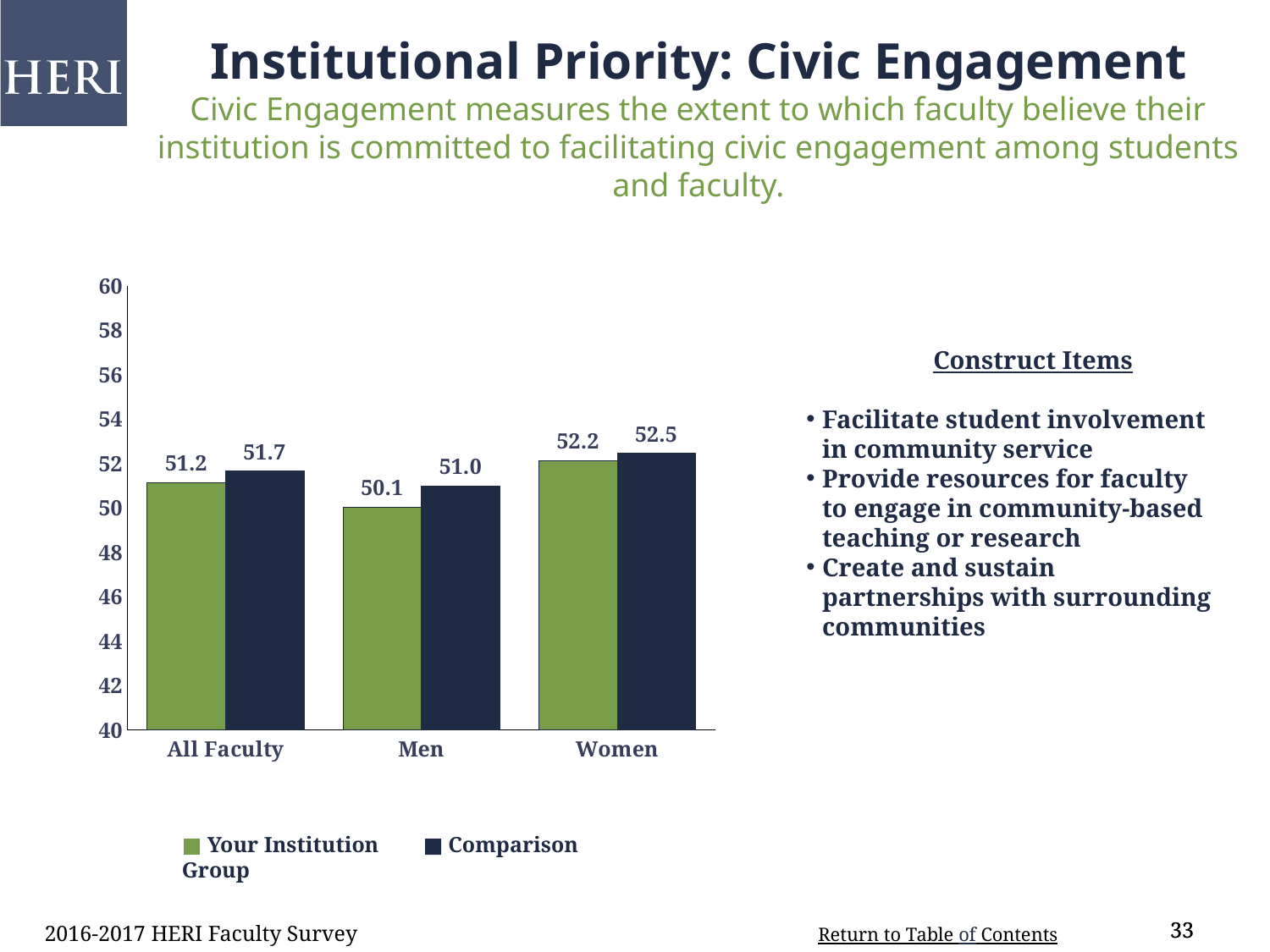
Is the Your Institution value for Women greater or less than 50? greater For All Faculty, which is larger: Your Institution or Comparison Group? Comparison Group What is the value for Your Institution for All Faculty? 51.2 Which category has the lowest Your Institution value? Men How many categories are shown on the x axis? 3 What kind of chart is shown on the slide? bar chart What is the difference between the Comparison Group and Your Institution values for Men? 0.9 Which category has the highest Comparison Group value? Women What is the difference between the Your Institution values for Women and Men? 2.1 How many series does the legend list? 2 What is the value for Your Institution for Men? 50.1 What is the value for Comparison Group for Women? 52.5